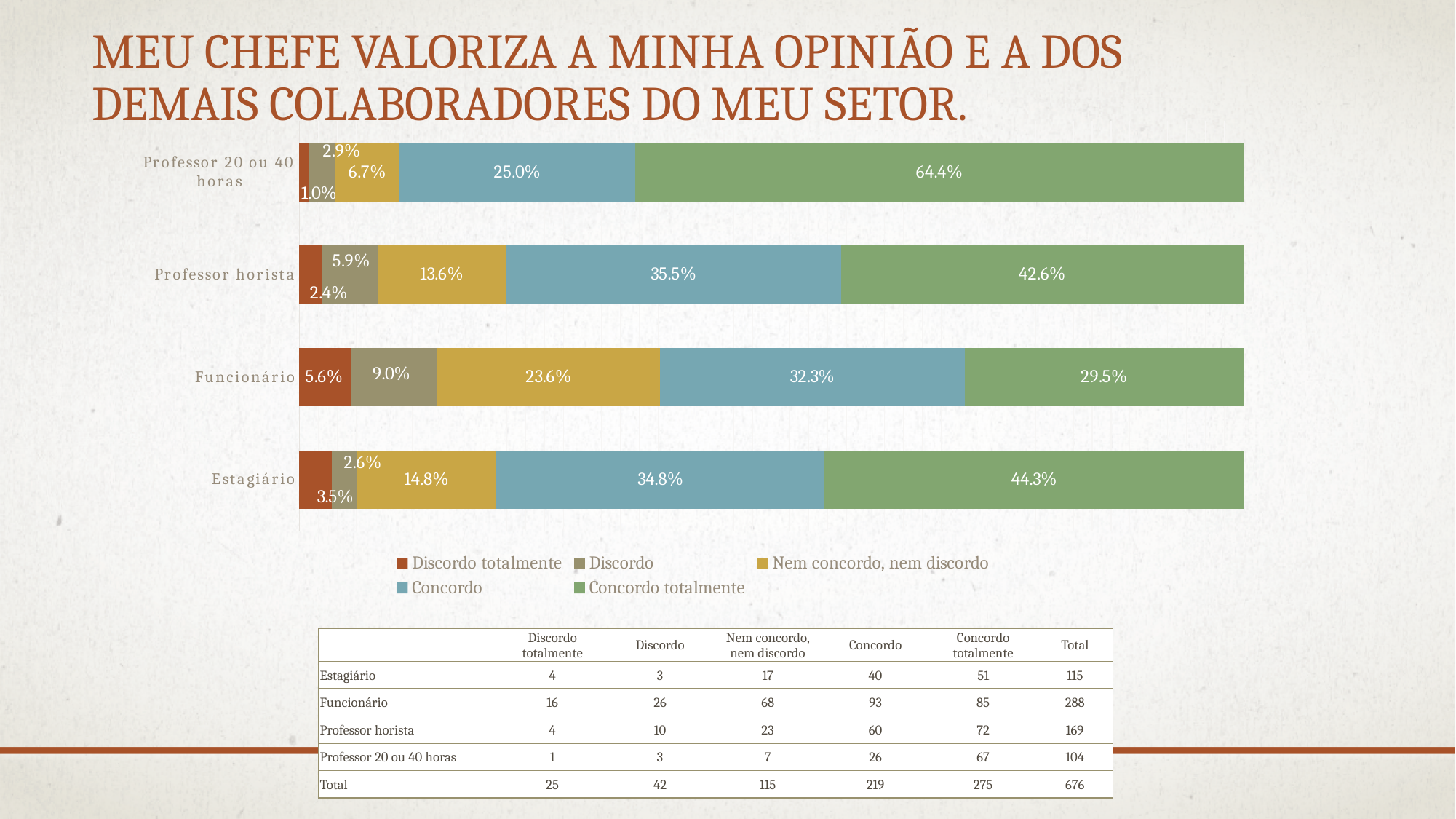
What is the difference between the Concordo totalmente values for Professor horista and Funcionário? 13.1% What is the value for Nem concordo, nem discordo for Funcionário? 23.6% Which category has the lowest value for Discordo totalmente? Professor 20 ou 40 horas What is the value for Concordo for Estagiário? 34.8% How many series does the legend list? 5 What is the value for Concordo totalmente for Professor 20 ou 40 horas? 64.4% Which category has the highest value for Concordo totalmente? Professor 20 ou 40 horas What kind of chart is shown on the slide? Stacked bar chart Which colour represents Concordo totalmente in the legend? Green What is the value for Discordo totalmente for Professor horista? 2.4% Which is larger for Funcionário: Concordo or Concordo totalmente? Concordo How many categories are shown on the chart? 4